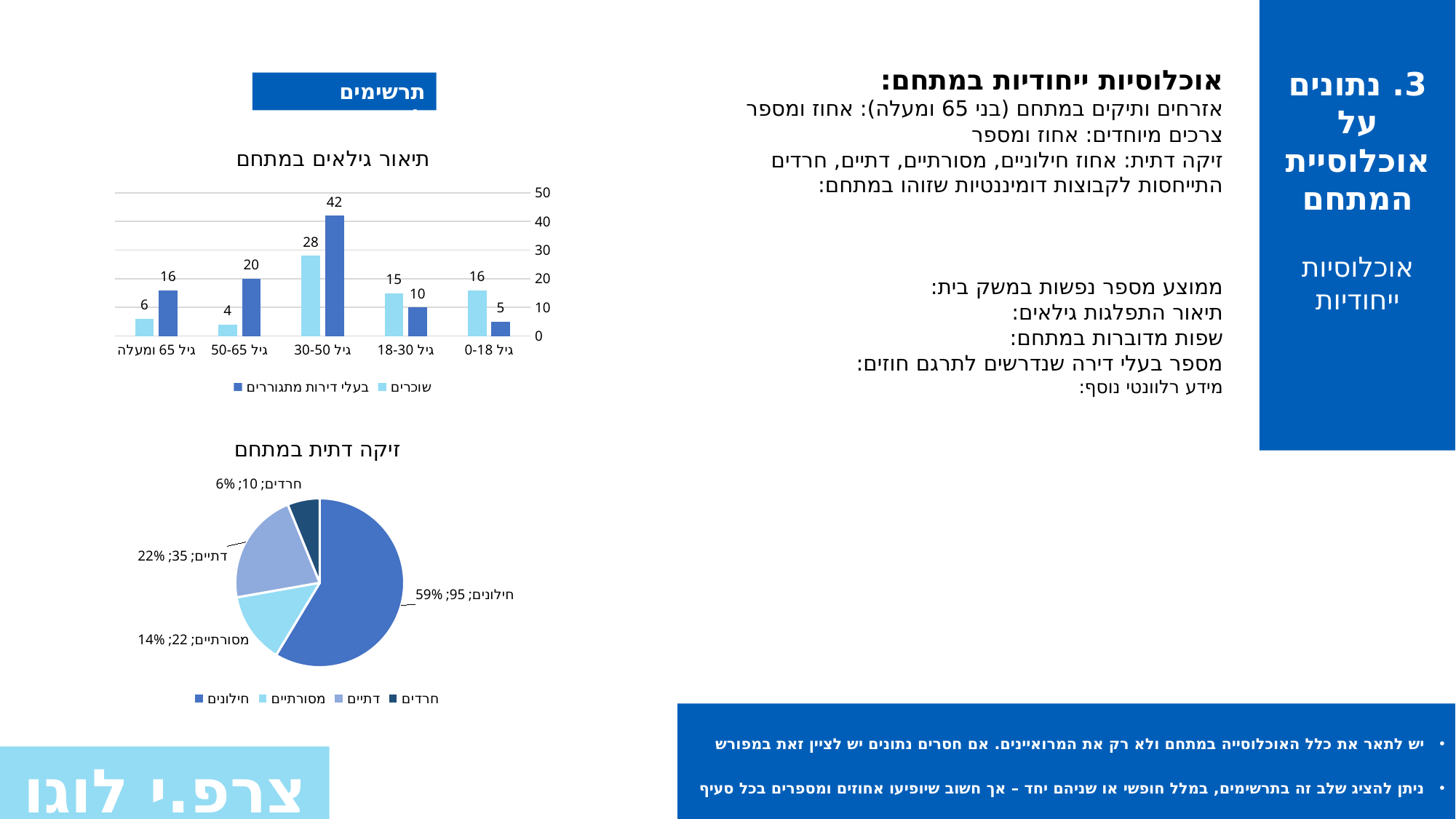
How many age categories are shown in the bar chart titled "תיאור גילאים במתחם"? 5 In the bar chart titled "תיאור גילאים במתחם", what is the value for "שוכרים" in the "גיל 50-65" category? 4 In the bar chart titled "תיאור גילאים במתחם", which is larger in the "גיל 0-18" category: "שוכרים" or "בעלי דירות מתגוררים"? שוכרים In the pie chart titled "זיקה דתית במתחם", which group has the smallest slice? חרדים In the bar chart titled "תיאור גילאים במתחם", what is the difference between "בעלי דירות מתגוררים" and "שוכרים" in the "גיל 30-50" category? 14 In the bar chart titled "תיאור גילאים במתחם", which age category has the highest value for "שוכרים"? גיל 30-50 How many series does the legend of the bar chart titled "תיאור גילאים במתחם" list? 2 In the bar chart titled "תיאור גילאים במתחם", what is the value for "בעלי דירות מתגוררים" in the "גיל 30-50" category? 42 In the bar chart titled "תיאור גילאים במתחם", which age category has the lowest value for "בעלי דירות מתגוררים"? גיל 0-18 In the pie chart titled "זיקה דתית במתחם", what share does "חילונים" have? 59% What kind of chart is the chart titled "זיקה דתית במתחם"? pie chart In the pie chart titled "זיקה דתית במתחם", what is the value for "דתיים"? 35